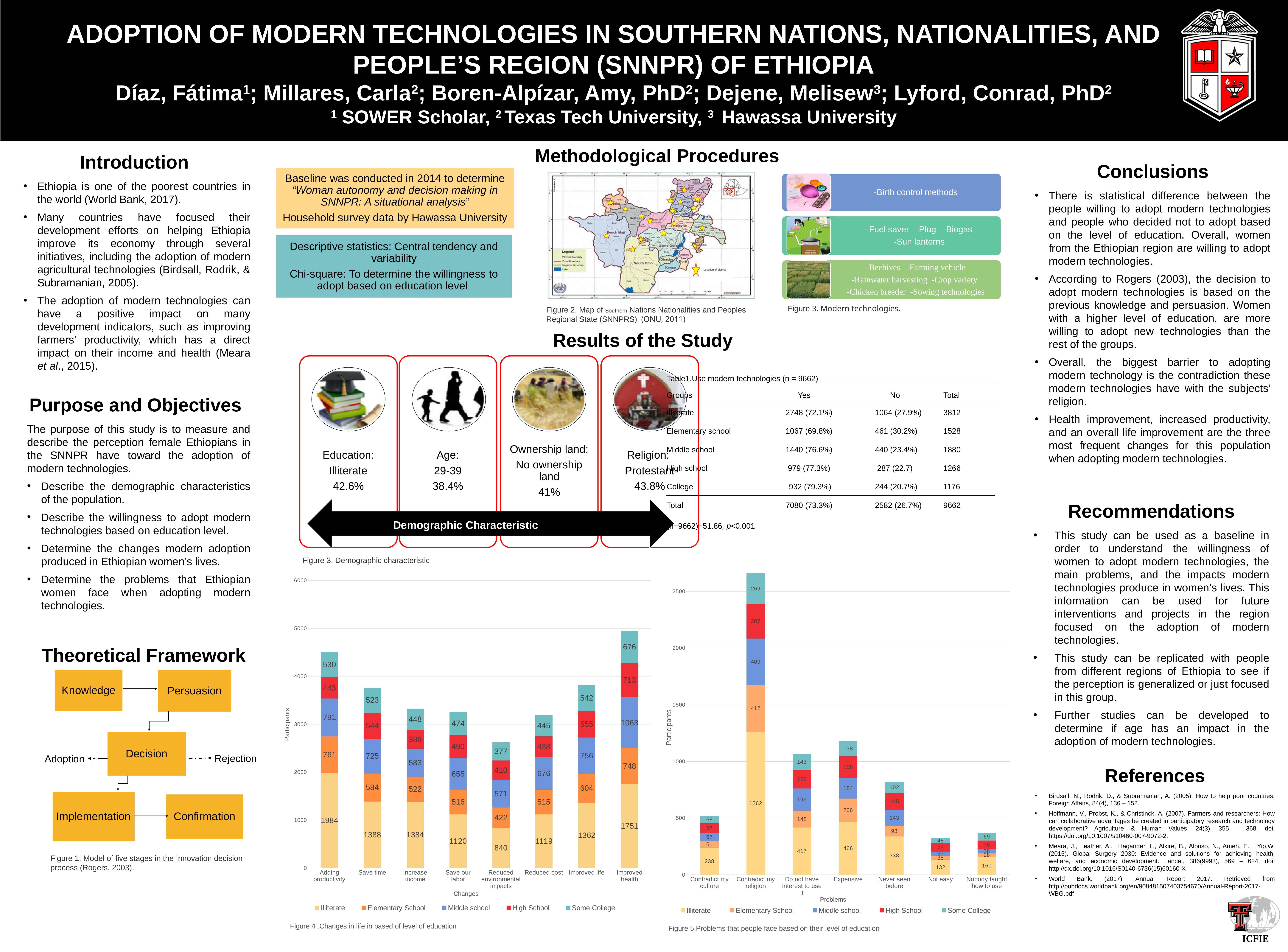
What kind of chart is the right chart (Figure 5, problems that people face based on their level of education)? Stacked bar chart In the left chart (Figure 4, changes in life based on level of education), which change has the lowest Illiterate value? Reduced environmental impacts In the right chart (Figure 5, problems that people face based on their level of education), what is the total of the stacked bar for Expensive? 1182 In the left chart (Figure 4, changes in life based on level of education), what is the difference between the Illiterate values for Adding productivity and Save time? 596 In the left chart (Figure 4, changes in life based on level of education), how many series does the legend list? 5 In the right chart (Figure 5, problems that people face based on their level of education), which is larger: the High School value for Not easy or the High School value for Nobody taught how to use? Nobody taught how to use In the left chart (Figure 4, changes in life based on level of education), what is the Illiterate value for Adding productivity? 1984 In the left chart (Figure 4, changes in life based on level of education), what is the Middle school value for Improved health? 1063 In the left chart (Figure 4, changes in life based on level of education), how many change categories are shown on the x axis? 8 In the right chart (Figure 5, problems that people face based on their level of education), what is the Illiterate value for Contradict my religion? 1262 In the left chart (Figure 4, changes in life based on level of education), what is the total of the stacked bar for Improved health? 4951 In the right chart (Figure 5, problems that people face based on their level of education), which problem has the highest total stacked bar? Contradict my religion